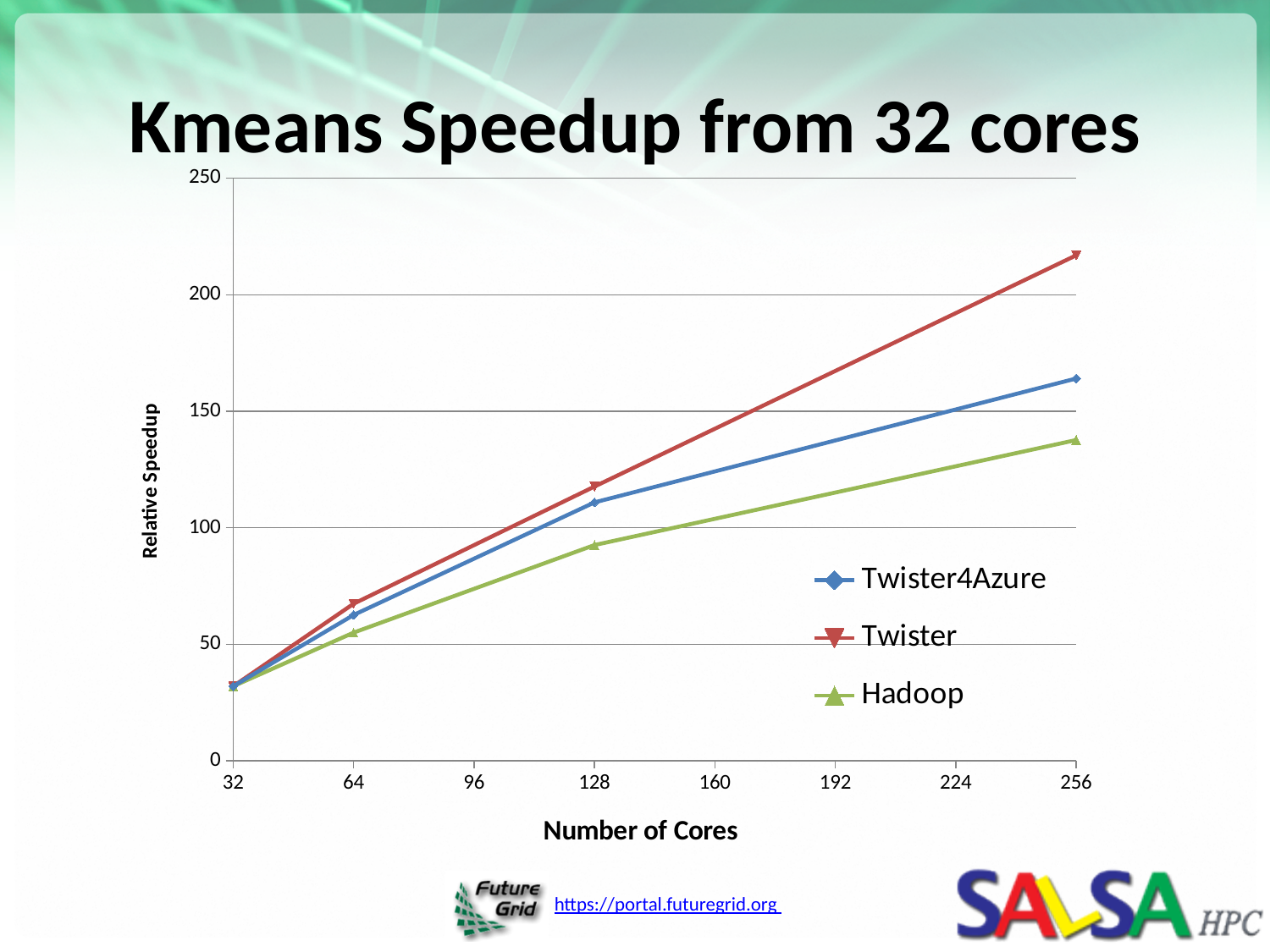
Is the relative speedup for Hadoop at 128 cores greater or less than 100? less Does the relative speedup for Twister rise or fall as the number of cores increases? rise What is the label of the x axis? Number of Cores At 256 cores, which has the larger relative speedup, Twister4Azure or Hadoop? Twister4Azure Is the relative speedup for Twister at 256 cores greater or less than 200? greater Which series has the lowest relative speedup at 256 cores? Hadoop How many data points are plotted for the Hadoop series? 4 Is the relative speedup for Hadoop at 256 cores greater or less than 150? less How many series does the legend list? 3 Which series has the highest relative speedup at 256 cores? Twister What kind of chart is shown on the slide? line chart